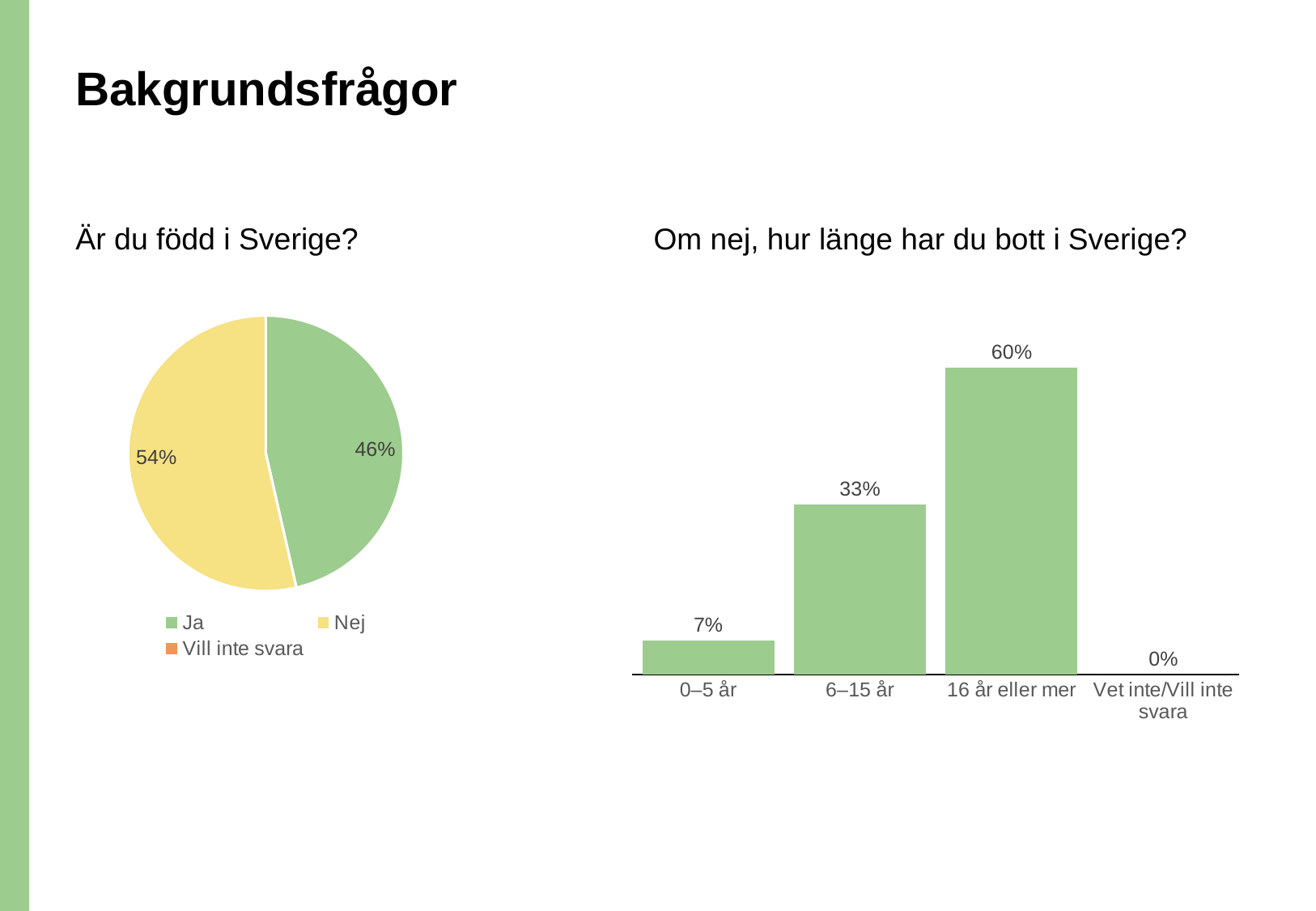
In the chart titled "Om nej, hur länge har du bott i Sverige?", which category has the highest value? 16 år eller mer In the chart titled "Om nej, hur länge har du bott i Sverige?", which category has the lowest value? Vet inte/Vill inte svara In the chart titled "Är du född i Sverige?", which answer has the larger share, "Ja" or "Nej"? Nej In the chart titled "Om nej, hur länge har du bott i Sverige?", what is the value for "6–15 år"? 33% What kind of chart is the chart titled "Är du född i Sverige?"? Pie chart How many categories are shown on the x axis of the chart titled "Om nej, hur länge har du bott i Sverige?"? 4 How many entries does the legend of the chart titled "Är du född i Sverige?" list? 3 In the chart titled "Är du född i Sverige?", what share of respondents answered "Ja"? 46% In the chart titled "Om nej, hur länge har du bott i Sverige?", what is the difference between "16 år eller mer" and "6–15 år"? 27 percentage points In the chart titled "Är du född i Sverige?", what share of respondents answered "Nej"? 54% In the chart titled "Om nej, hur länge har du bott i Sverige?", what is the value for "0–5 år"? 7% In the chart titled "Är du född i Sverige?", what is the difference in percentage points between "Nej" and "Ja"? 8 percentage points